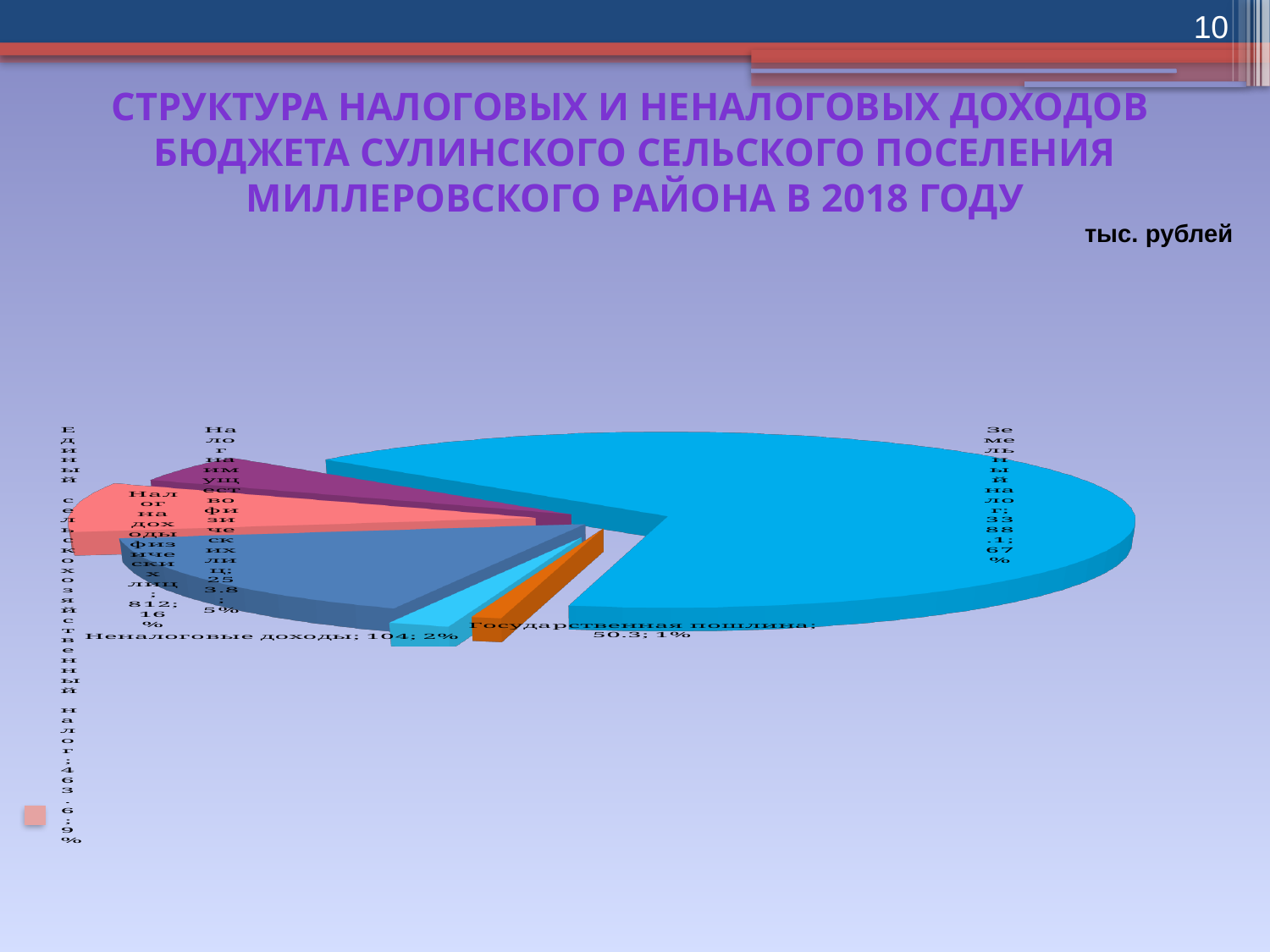
In what units are the values on the chart given? тыс. рублей Which category has the largest slice of the pie? Земельный налог Which category has the smallest slice of the pie? Государственная пошлина What share of the pie does Земельный налог represent? 67% What is the value for Земельный налог? 3388.1 What is the value for Государственная пошлина? 50.3 What is the difference between the values for Земельный налог and Налог на доходы физических лиц? 2576.1 What is the value for Налог на доходы физических лиц? 812 What type of chart is shown on the slide? Pie chart What share of the pie does Единый сельскохозяйственный налог represent? 9% Which is larger: Неналоговые доходы or Государственная пошлина? Неналоговые доходы How many slices does the pie chart have? 6